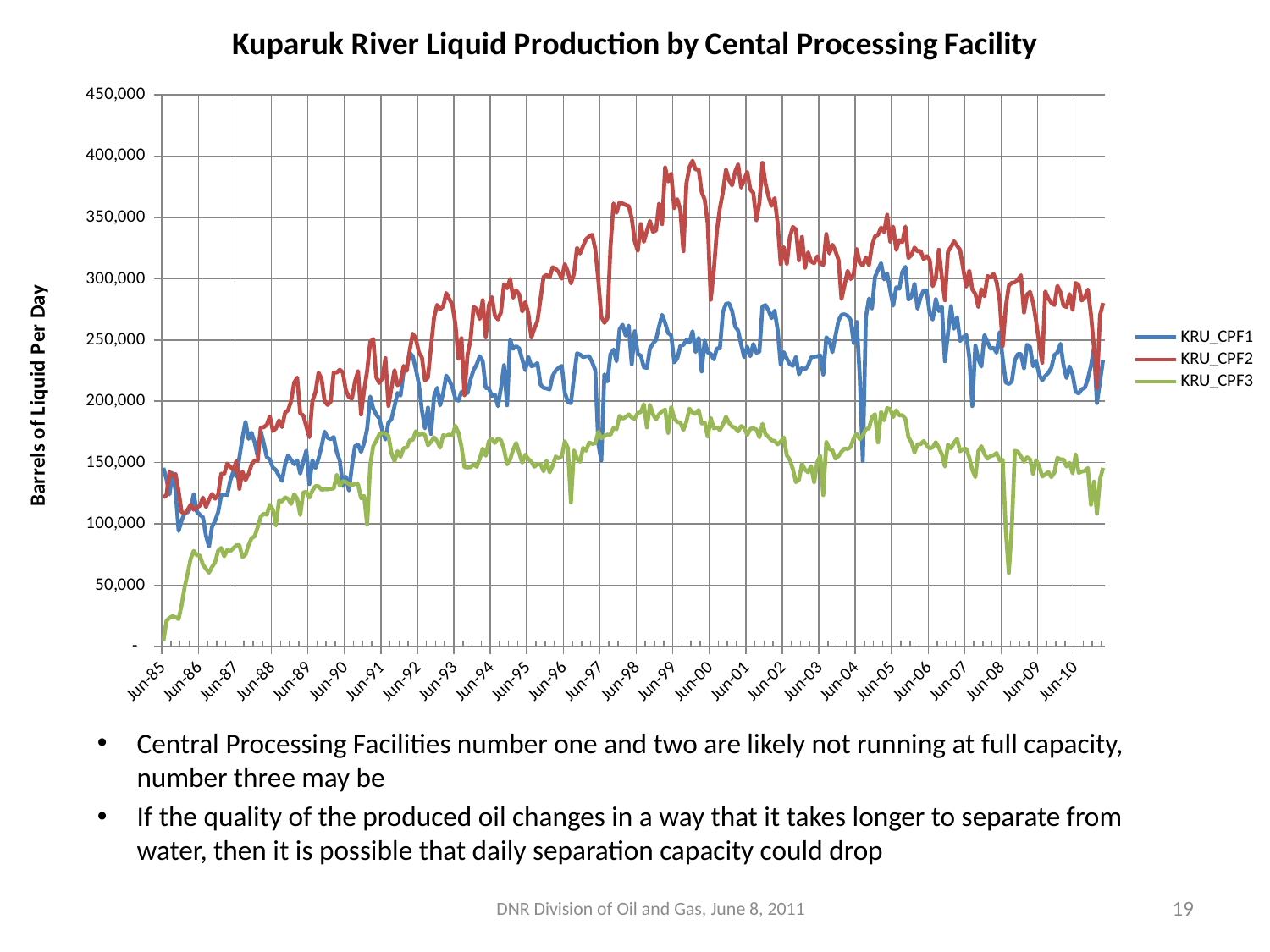
Is the value for KRU_CPF1 around Jun-86 greater or less than 150,000? less What is the label on the vertical axis of the chart? Barrels of Liquid Per Day How many series does the legend list? 3 Is the value for KRU_CPF3 at Jun-85 greater or less than 50,000? less Does the KRU_CPF3 series rise or fall between Jun-85 and Jun-90? rise Is the value for KRU_CPF2 around Jun-99 greater or less than 350,000? greater Which colour is used for the KRU_CPF2 series? red Around Jun-99, which is larger: KRU_CPF2 or KRU_CPF3? KRU_CPF2 What kind of chart is shown on the slide? line chart Which series has the highest values around Jun-00? KRU_CPF2 Which series has the lowest values around Jun-05? KRU_CPF3